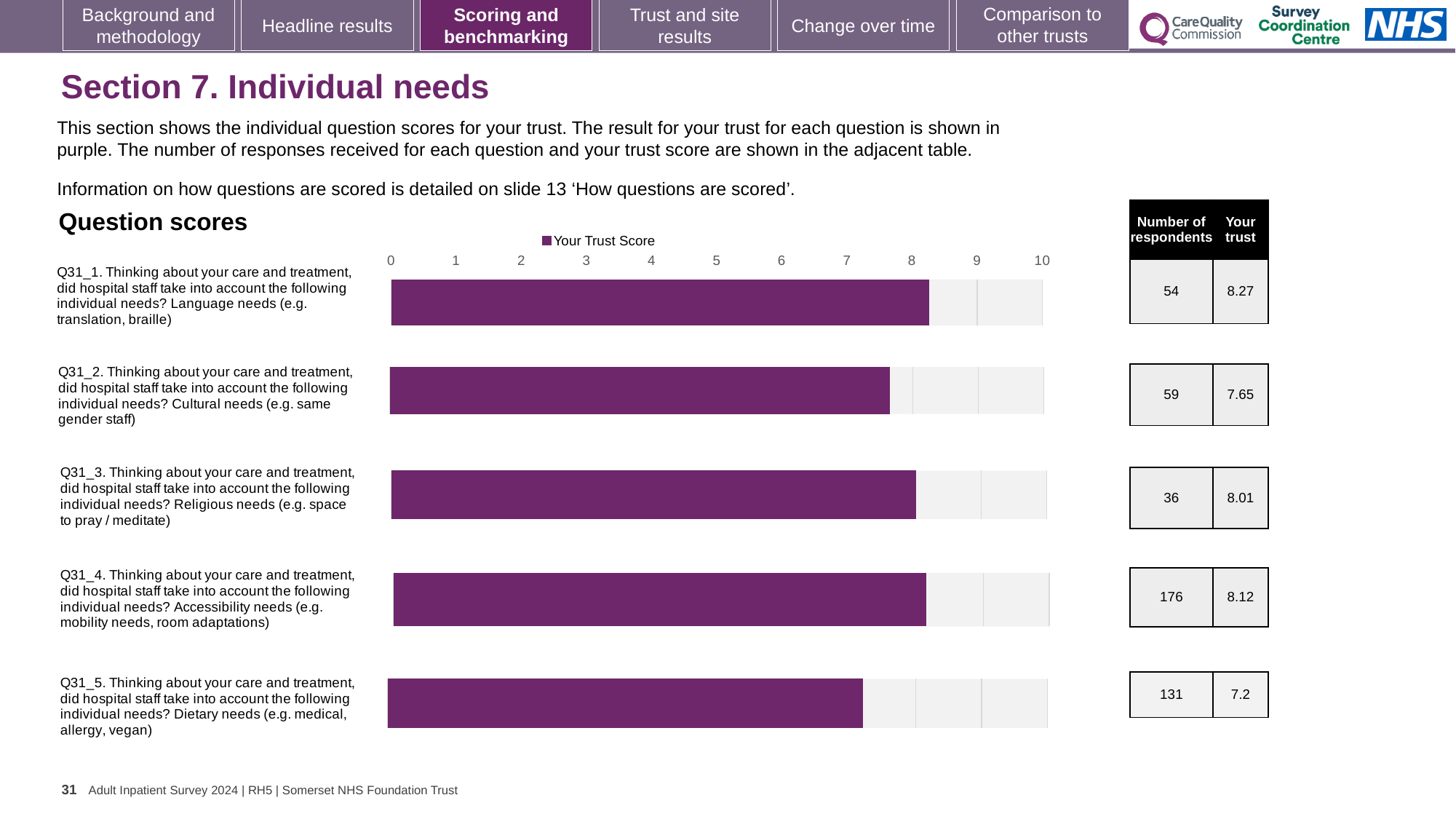
What is the name of the series shown in the chart legend? Your Trust Score What kind of chart is shown on the slide? Bar chart What is the trust score for Q31_5 (Dietary needs)? 7.2 What is the difference between the trust scores for Q31_1 (Language needs) and Q31_5 (Dietary needs)? 1.07 Which question has the highest trust score? Q31_1 (Language needs) What is the trust score for Q31_3 (Religious needs)? 8.01 Which question has the lowest trust score? Q31_5 (Dietary needs) How many questions are plotted in the chart? 5 How many series does the chart legend list? 1 Which has a higher trust score, Q31_2 (Cultural needs) or Q31_4 (Accessibility needs)? Q31_4 (Accessibility needs) Is the trust score for Q31_2 (Cultural needs) greater or less than 8? less What is the trust score for Q31_1 (Language needs)? 8.27